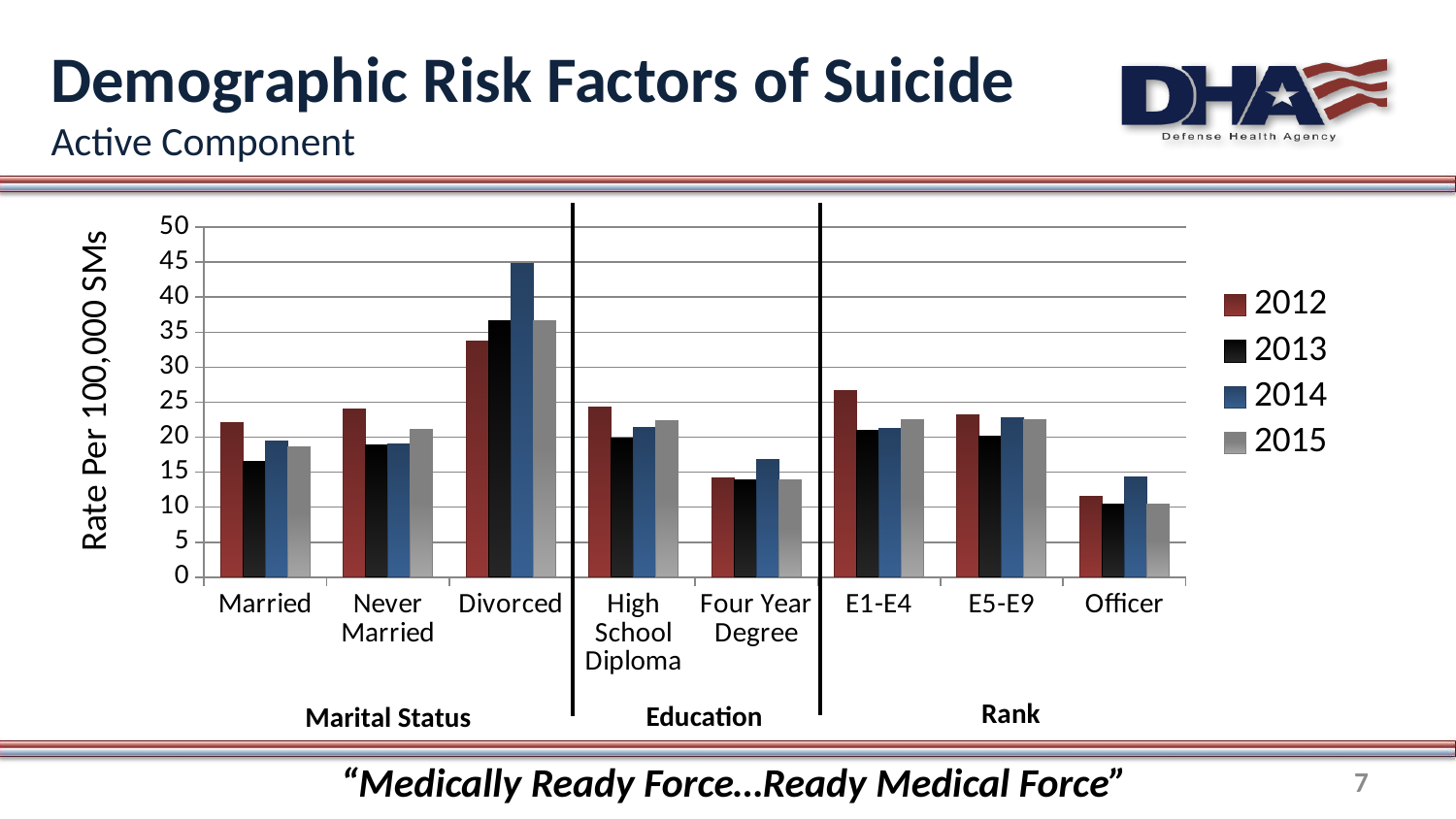
Is the 2012 value for Never Married greater or less than 20? greater For Divorced, which year has the larger value, 2012 or 2014? 2014 How many series does the legend list? 4 Is the 2014 value for Four Year Degree greater or less than 20? less Is the 2014 value for Divorced greater or less than 40? greater How many categories are shown along the x axis? 8 Which category has the lowest value for 2012? Officer Which category has the highest value for 2014? Divorced What kind of chart is shown on the slide? bar chart What is the label on the y axis? Rate Per 100,000 SMs For E1-E4, which year has the larger value, 2012 or 2013? 2012